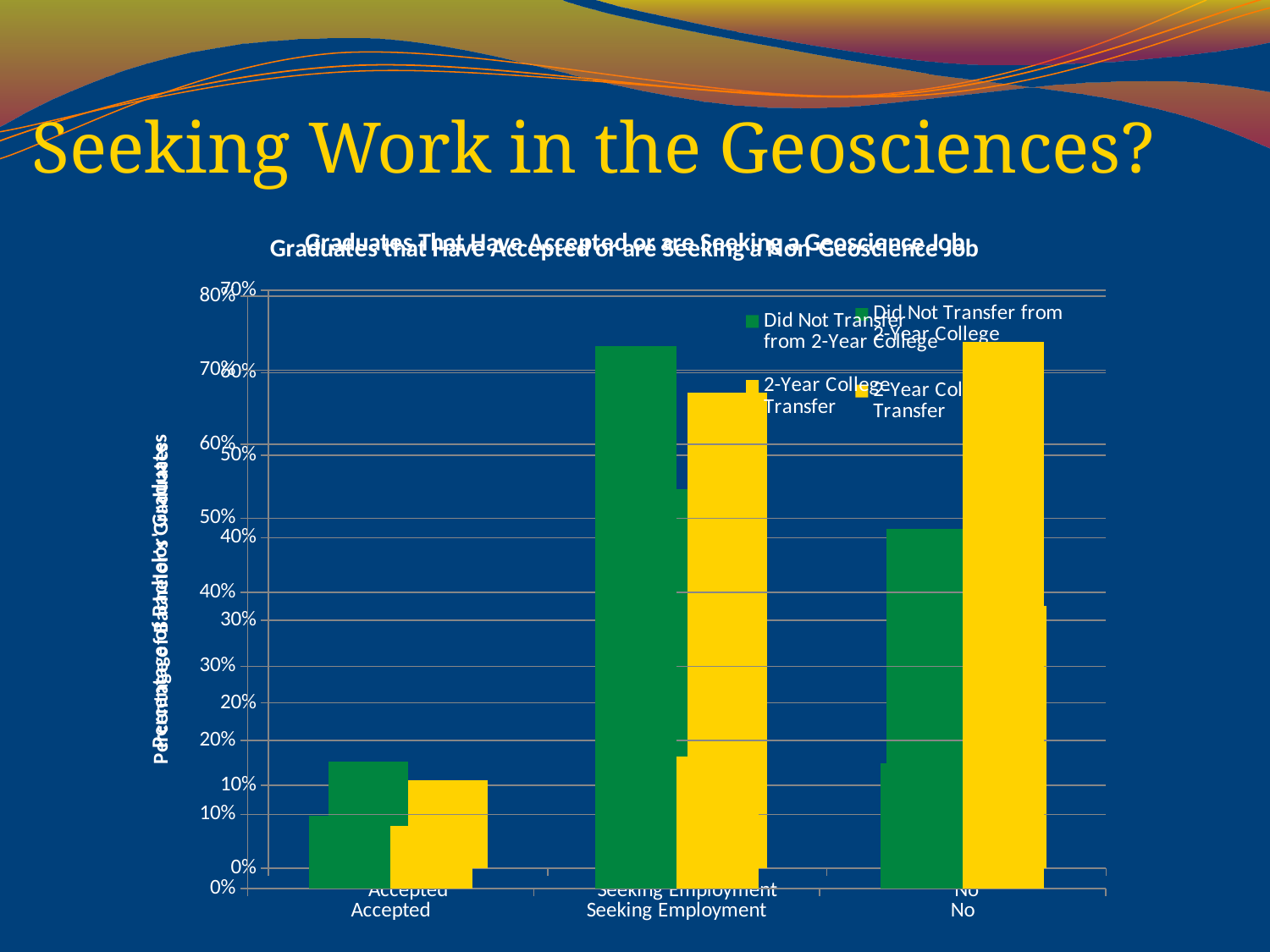
In the chart titled 'Graduates that Have Accepted or are Seeking a Non-Geoscience Job', is the value for 'Did Not Transfer from 2-Year College' at Accepted greater or less than 30%? less In the chart titled 'Graduates That Have Accepted or are Seeking a Geoscience Job', which category has the lowest value for 'Did Not Transfer from 2-Year College'? Accepted What kind of chart is used on this slide? bar chart In the chart titled 'Graduates That Have Accepted or are Seeking a Geoscience Job', is the value for 'Did Not Transfer from 2-Year College' at Seeking Employment greater or less than 40%? greater In the chart titled 'Graduates That Have Accepted or are Seeking a Geoscience Job', which category has the lowest value for '2-Year College Transfer'? Accepted Which colour represents '2-Year College Transfer' in the charts on this slide? yellow What are the two legend entries in the chart titled 'Graduates That Have Accepted or are Seeking a Geoscience Job'? Did Not Transfer from 2-Year College; 2-Year College Transfer How many categories are shown along the x axis of the chart titled 'Graduates that Have Accepted or are Seeking a Non-Geoscience Job'? 3 How many series does the legend list in the chart titled 'Graduates That Have Accepted or are Seeking a Geoscience Job'? 2 In the chart titled 'Graduates that Have Accepted or are Seeking a Non-Geoscience Job', which category has the highest value for '2-Year College Transfer'? No In the chart titled 'Graduates That Have Accepted or are Seeking a Geoscience Job', is the value for '2-Year College Transfer' at Accepted greater or less than 30%? less In the chart titled 'Graduates that Have Accepted or are Seeking a Non-Geoscience Job', which category has the highest value for 'Did Not Transfer from 2-Year College'? Seeking Employment